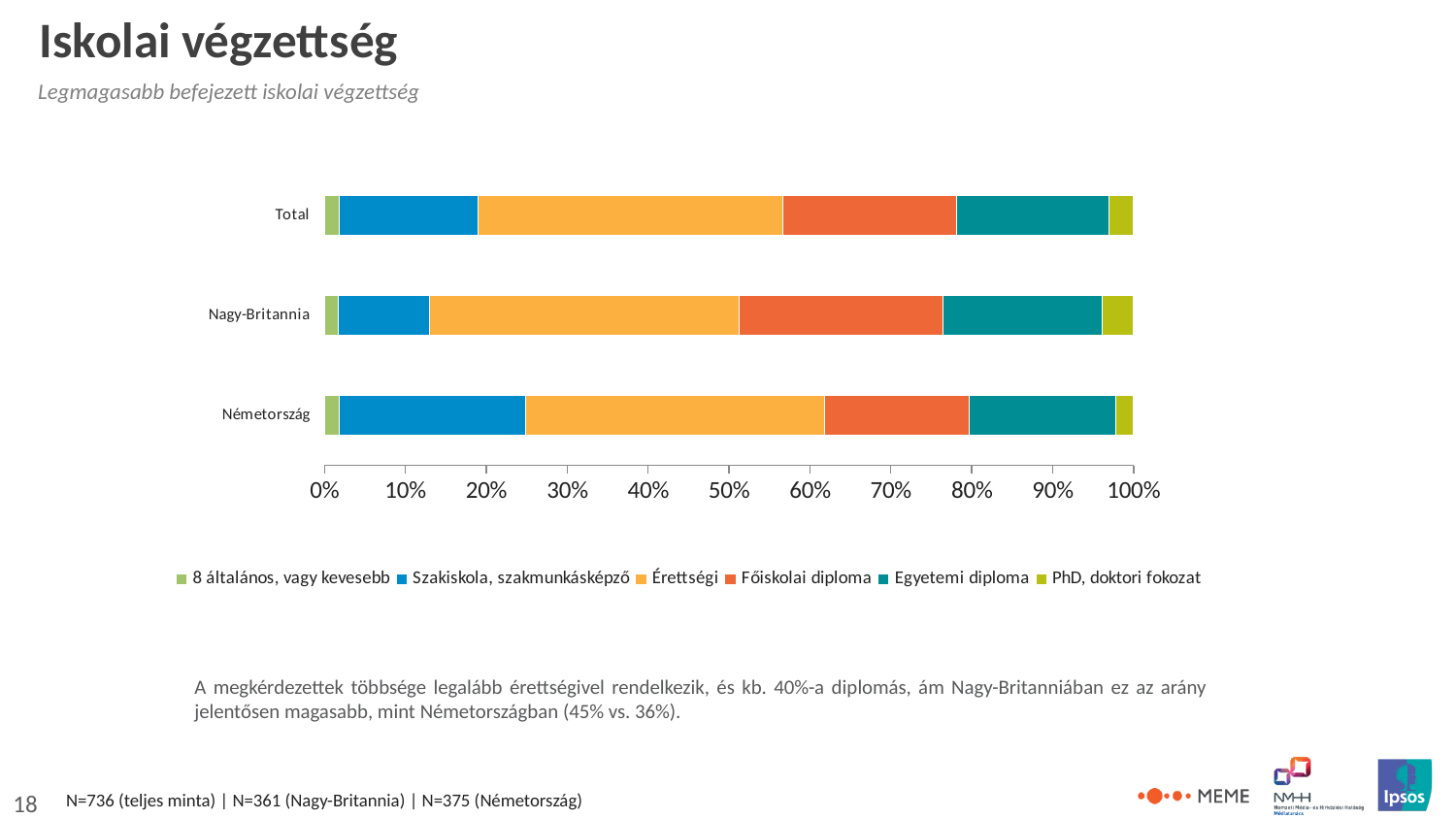
Is the 'Szakiskola, szakmunkásképző' share for Nagy-Britannia greater or less than 20%? less What is the title of the slide containing the chart? Iskolai végzettség What kind of chart is shown on the slide? stacked bar chart Is the 'Szakiskola, szakmunkásképző' segment larger for Németország or for Nagy-Britannia? Németország Which category has the smallest 'Szakiskola, szakmunkásképző' segment? Nagy-Britannia How many series does the legend list? 6 Is the 'Érettségi' share for Total greater or less than 30%? greater Which category has the largest 'Szakiskola, szakmunkásképző' segment? Németország Which legend entry is shown in orange (the third series)? Érettségi Is the 'Főiskolai diploma' segment larger for Nagy-Britannia or for Németország? Nagy-Britannia How many categories (bars) does the chart show? 3 Is the 'Szakiskola, szakmunkásképző' share for Németország greater or less than 20%? greater